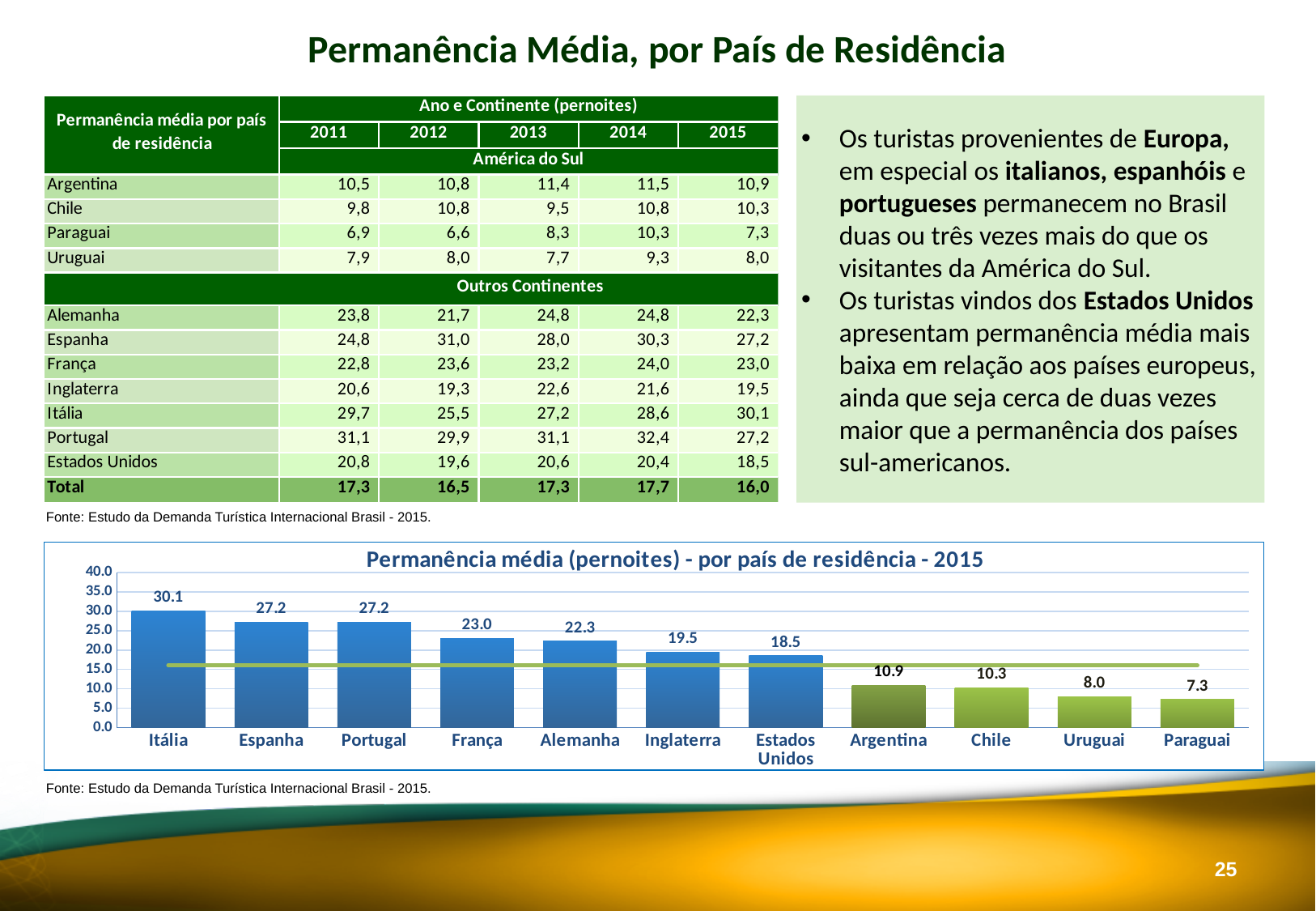
What is the difference between the values for Itália and Paraguai? 22.8 Which has a larger value, Argentina or Chile? Argentina What is the value for Itália in the chart? 30.1 Which country has the highest value in the chart? Itália Do the bar values rise or fall from left to right along the x axis? fall What kind of chart is shown on the slide? bar chart What is the value for Uruguai in the chart? 8.0 Which country has the lowest value in the chart? Paraguai Is the value for Inglaterra greater or less than 15.0? greater How many countries are shown in the chart? 11 What is the value for Estados Unidos in the chart? 18.5 What is the difference between the values for França and Alemanha? 0.7